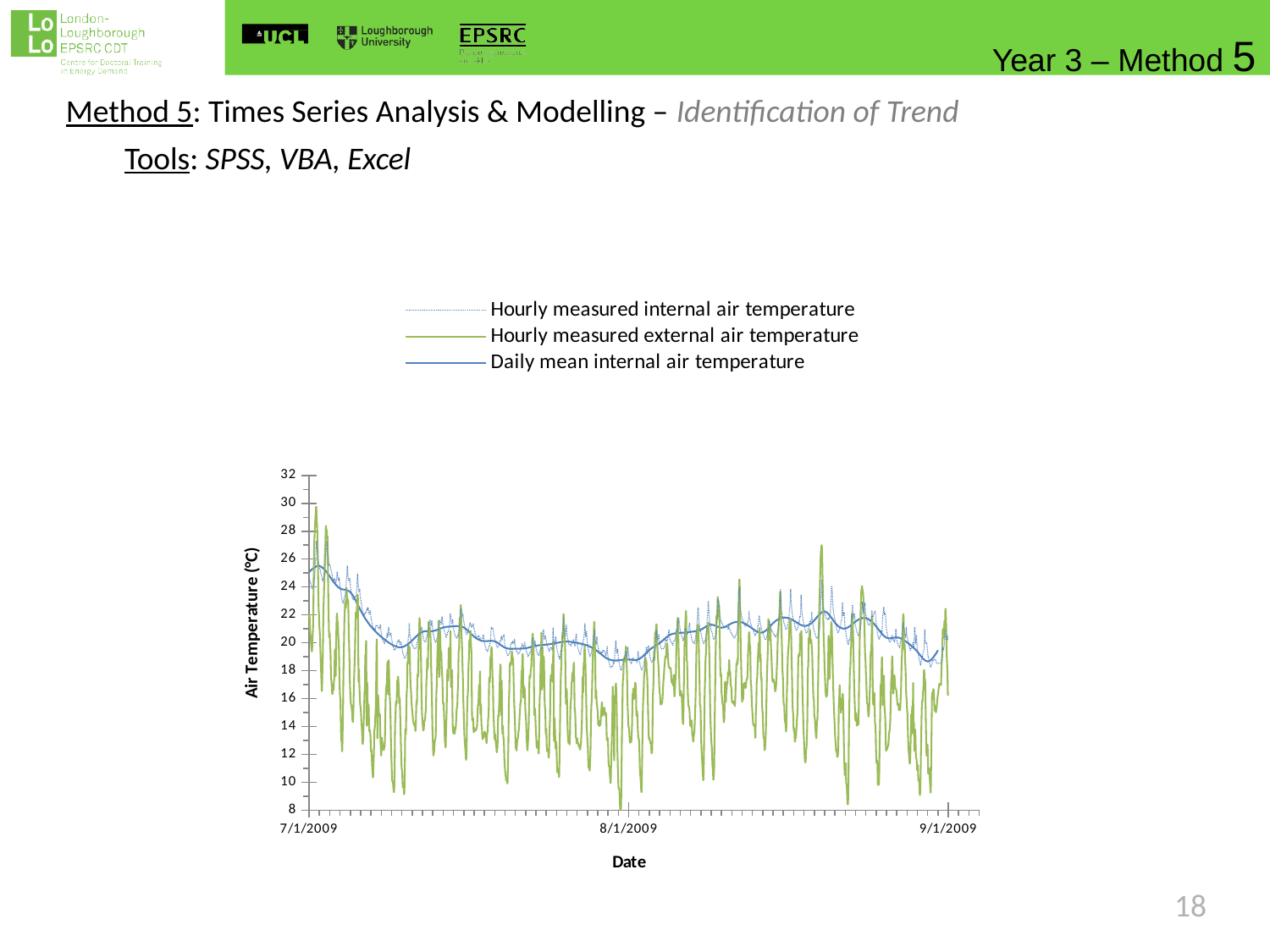
What is the title of the horizontal axis of the chart? Date What kind of chart is shown on the slide? line chart How many date labels are shown on the horizontal axis of the chart? 3 How many series does the chart's legend list? 3 What is the title of the vertical axis of the chart? Air Temperature (°C) What is the lowest value shown on the vertical axis of the chart? 8 Is the daily mean internal air temperature at 7/1/2009 greater or less than 24? greater What is the highest value shown on the vertical axis of the chart? 32 Is the daily mean internal air temperature at 8/1/2009 greater or less than 22? less Does the daily mean internal air temperature rise or fall between 7/1/2009 and mid-July 2009? fall Does the hourly measured external air temperature ever drop below 10 during the period shown? yes